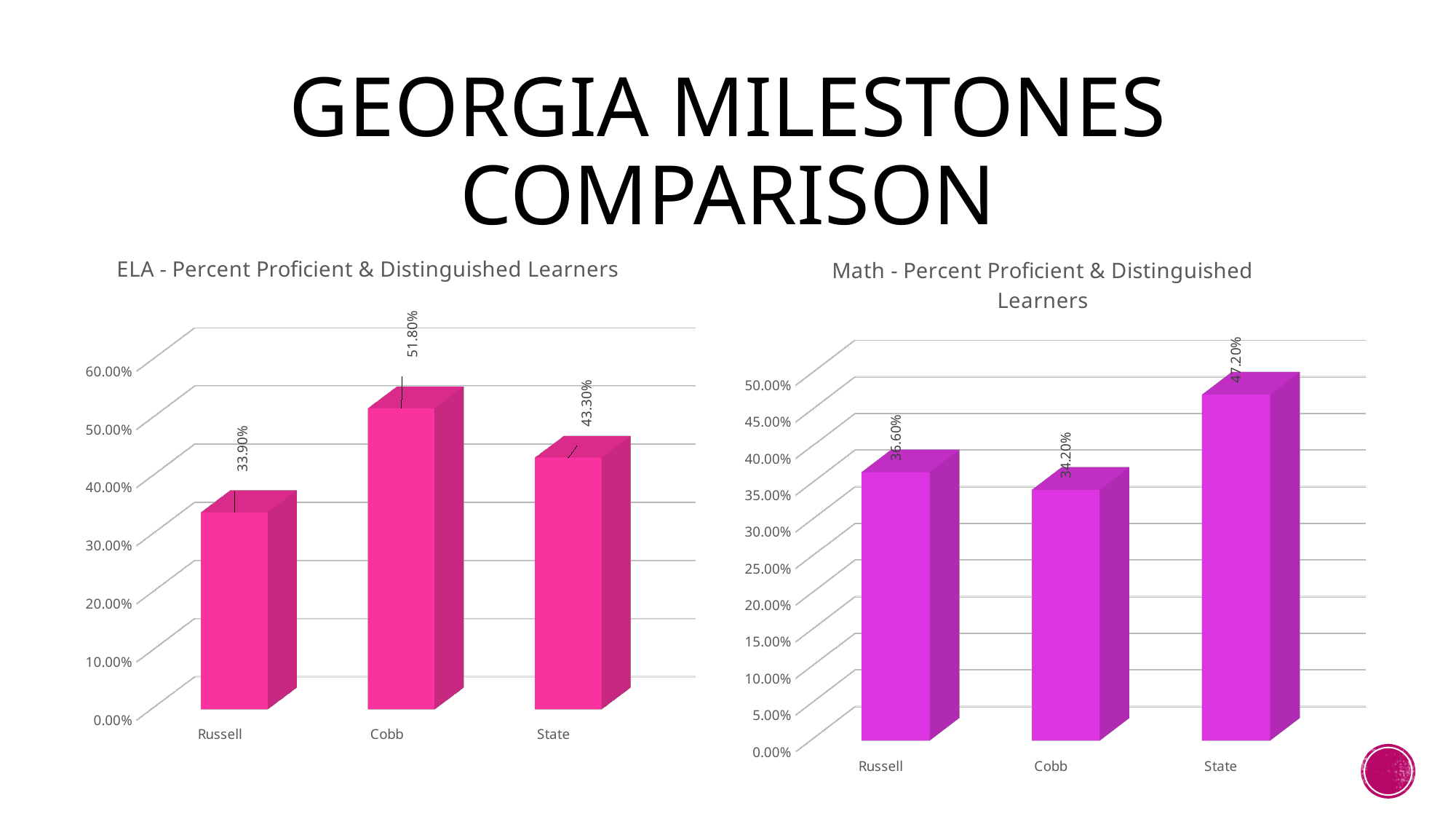
In the Math - Percent Proficient & Distinguished Learners chart, what is the value for State? 47.20% In the Math - Percent Proficient & Distinguished Learners chart, what is the difference between the values for State and Russell? 10.60% In the Math - Percent Proficient & Distinguished Learners chart, what is the value for Cobb? 34.20% In the Math - Percent Proficient & Distinguished Learners chart, which is larger, the value for Russell or the value for Cobb? Russell In the ELA - Percent Proficient & Distinguished Learners chart, what is the value for Russell? 33.90% In the Math - Percent Proficient & Distinguished Learners chart, which category has the lowest value? Cobb In the ELA - Percent Proficient & Distinguished Learners chart, is the value for State greater or less than 40.00%? greater In the ELA - Percent Proficient & Distinguished Learners chart, which category has the highest value? Cobb In the ELA - Percent Proficient & Distinguished Learners chart, what is the difference between the values for Cobb and Russell? 17.90% What kind of chart is the ELA - Percent Proficient & Distinguished Learners chart? Bar chart How many categories are shown in the Math - Percent Proficient & Distinguished Learners chart? 3 In the ELA - Percent Proficient & Distinguished Learners chart, what is the value for Cobb? 51.80%